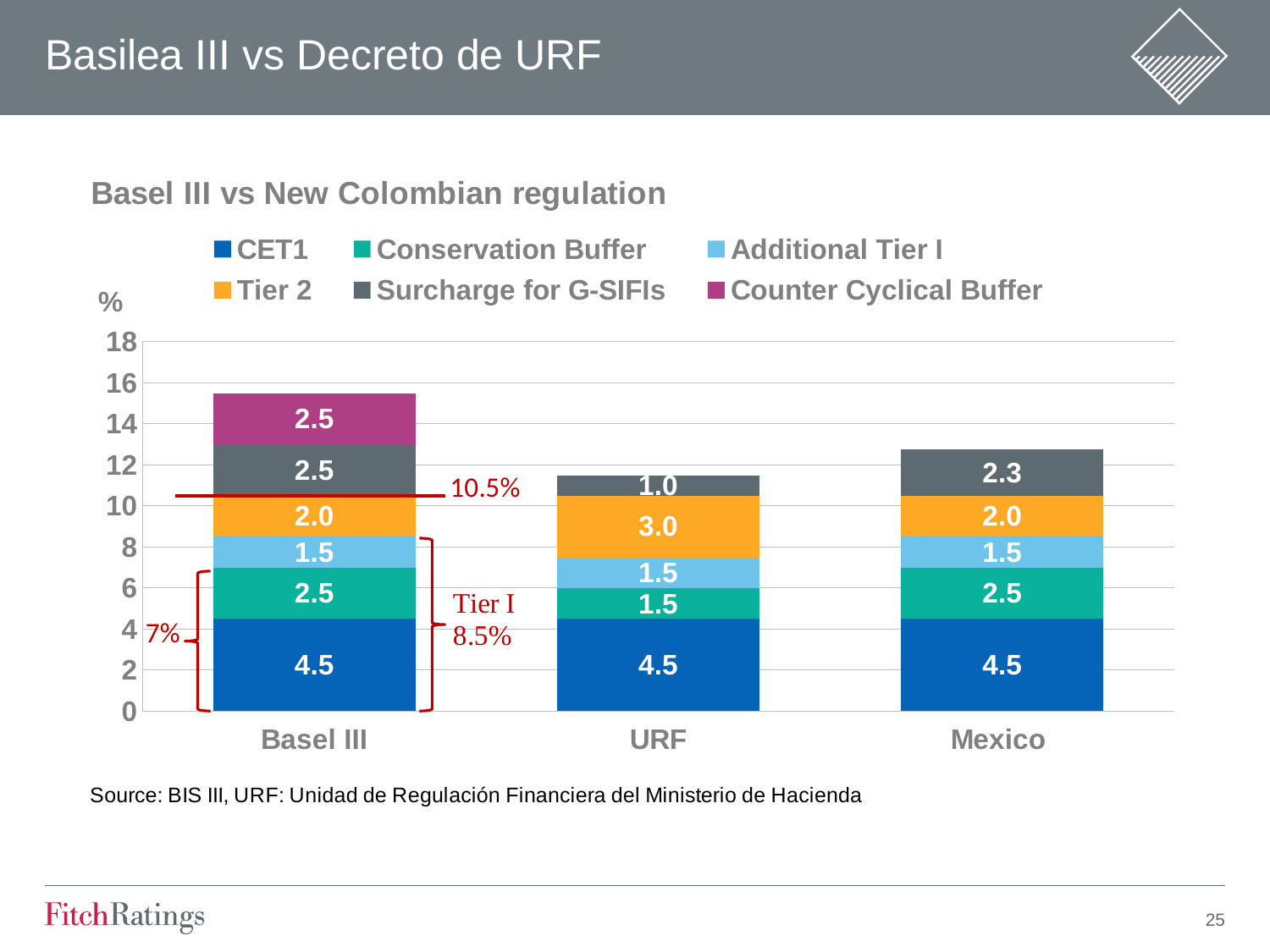
How many categories are shown on the x axis? 3 How many series does the legend list? 6 What is the Surcharge for G-SIFIs value for Mexico? 2.3 What is the total of the stacked bar for Basel III? 15.5 What kind of chart is shown on the slide? Stacked bar chart What is the total of the stacked bar for URF? 11.5 What is the Tier 2 value for URF? 3.0 What is the title of the chart? Basel III vs New Colombian regulation What is the Conservation Buffer value for URF? 1.5 Which is larger, the Conservation Buffer value for Basel III or for URF? Basel III What is the difference between the Tier 2 value for URF and the Tier 2 value for Mexico? 1.0 Which category has the highest total stacked bar? Basel III